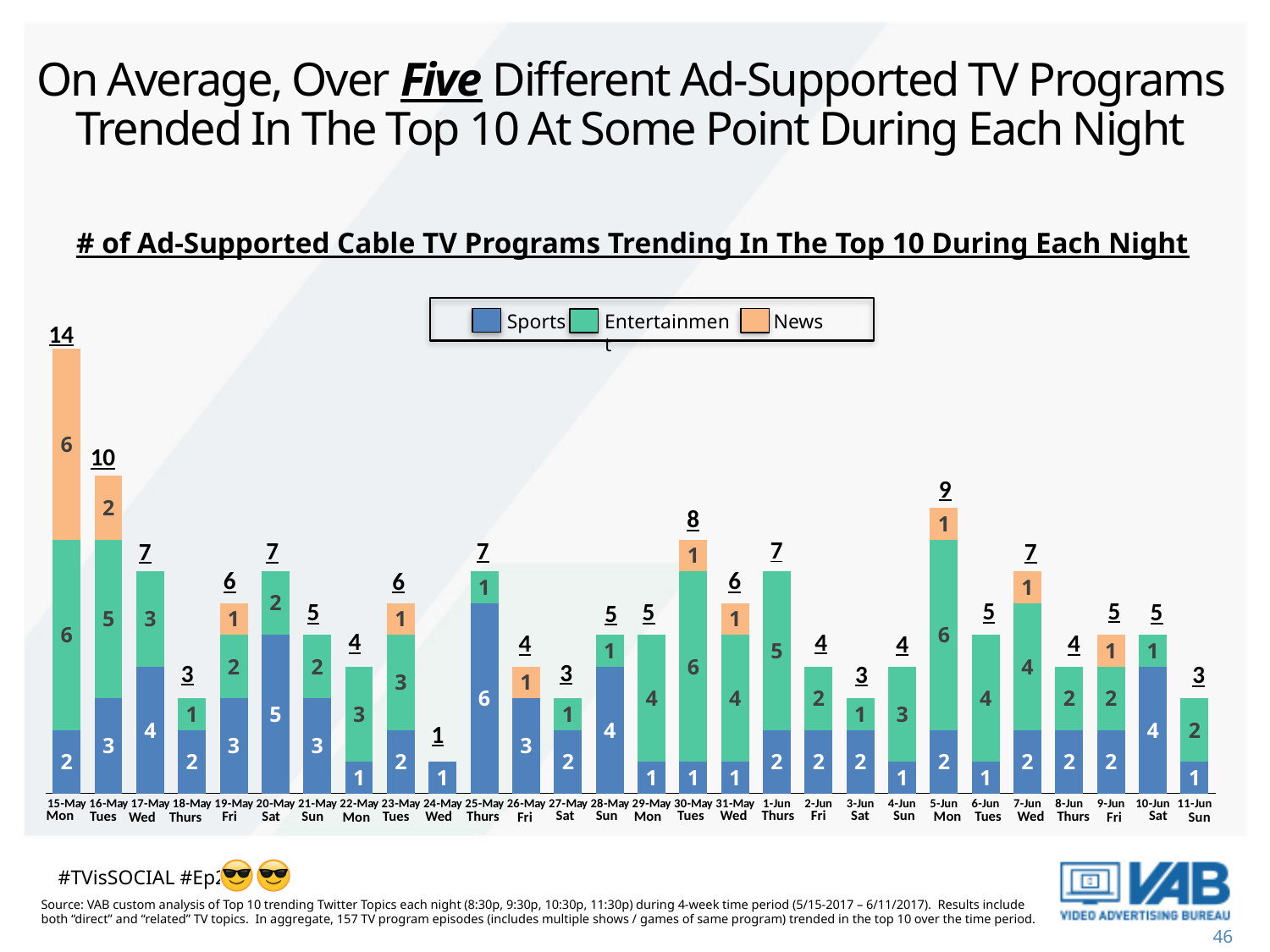
How many series does the legend list? 3 Which night has the lowest total number of programs trending in the top 10? 24-May (Wed) Which colour represents the Sports series in the chart? Blue What is the total number of ad-supported cable TV programs trending on 15-May (Mon)? 14 Which is larger: the total for 5-Jun (Mon) or the total for 30-May (Tues)? 5-Jun (Mon) How many Sports programs trended on 25-May (Thurs)? 6 What is the difference between the total for 15-May (Mon) and the total for 16-May (Tues)? 4 What type of chart is shown on the slide? Stacked bar chart How many News programs trended on 16-May (Tues)? 2 How many nights (bars) are shown on the chart? 28 How many Entertainment programs trended on 30-May (Tues)? 6 Which night has the highest total number of programs trending in the top 10? 15-May (Mon)